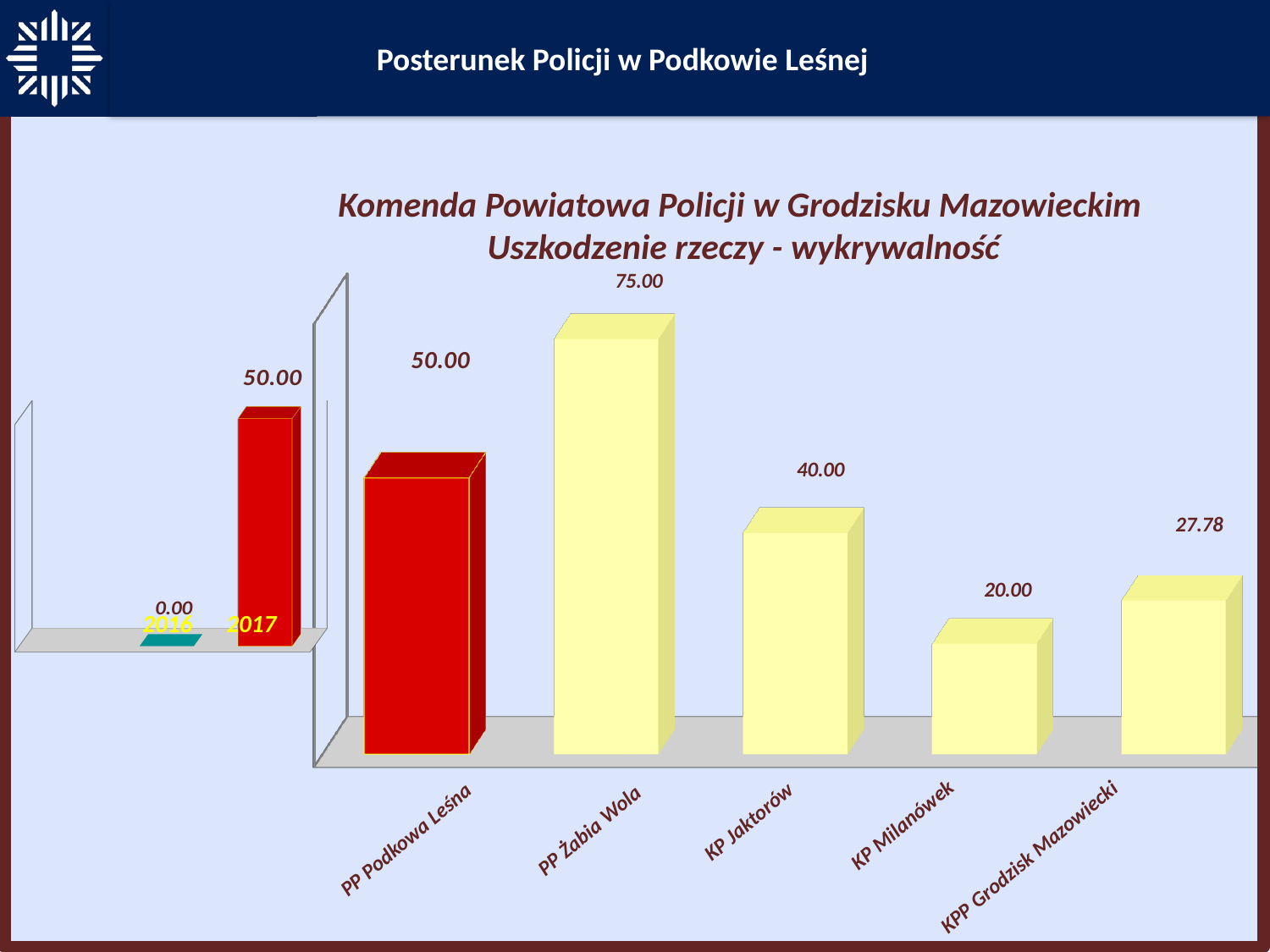
In the large chart titled 'Uszkodzenie rzeczy - wykrywalność', what is the value for PP Żabia Wola? 75.00 In the large chart titled 'Uszkodzenie rzeczy - wykrywalność', what is the value for KPP Grodzisk Mazowiecki? 27.78 In the small chart on the left, do the values rise or fall from 2016 to 2017? rise In the small chart on the left, what is the value for 2017? 50.00 In the large chart titled 'Uszkodzenie rzeczy - wykrywalność', which category has the lowest value? KP Milanówek What kind of chart is the large chart titled 'Uszkodzenie rzeczy - wykrywalność'? bar chart In the large chart titled 'Uszkodzenie rzeczy - wykrywalność', what is the value for KP Milanówek? 20.00 In the large chart titled 'Uszkodzenie rzeczy - wykrywalność', what is the difference between the values for PP Żabia Wola and KP Jaktorów? 35.00 In the large chart titled 'Uszkodzenie rzeczy - wykrywalność', which is larger: the value for PP Podkowa Leśna or KP Jaktorów? PP Podkowa Leśna In the large chart titled 'Uszkodzenie rzeczy - wykrywalność', which category has the highest value? PP Żabia Wola In the small chart on the left, what is the value for 2016? 0.00 How many categories are shown in the large chart titled 'Uszkodzenie rzeczy - wykrywalność'? 5